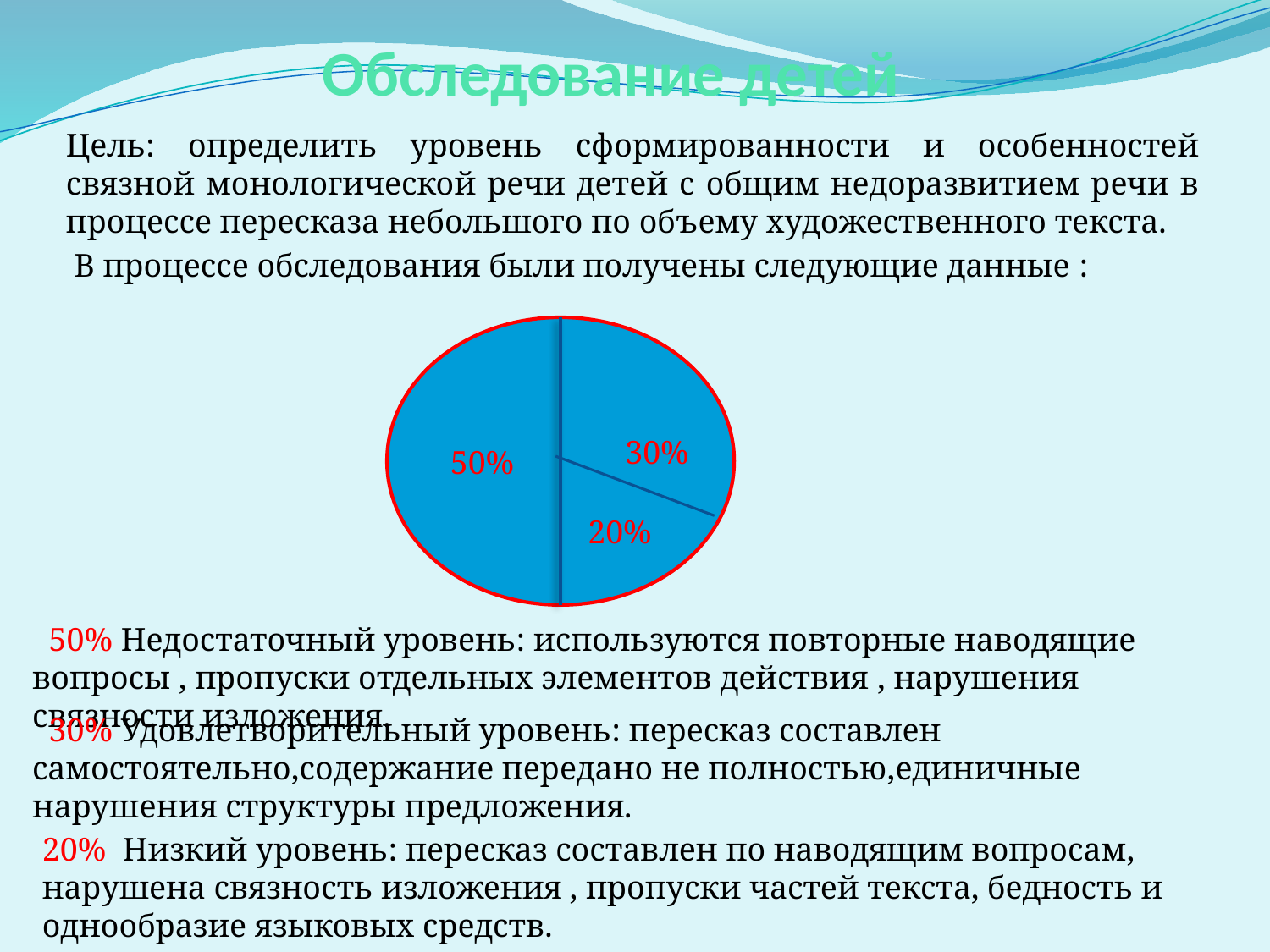
What share of the pie corresponds to the 'Недостаточный уровень' (insufficient level) according to the slide text? 50% What is the smallest share shown in the pie chart? 20% What colour are the slices of the pie chart? blue What is the difference in percentage points between the 30% slice and the 20% slice? 10 How many slices does the pie chart have? 3 Which slice is larger: the one labelled 30% or the one labelled 20%? 30% What share of the pie corresponds to the 'Удовлетворительный уровень' (satisfactory level) according to the slide text? 30% What is the total of all the percentages shown on the pie chart? 100% What is the largest share shown in the pie chart? 50% What share of the pie corresponds to the 'Низкий уровень' (low level) according to the slide text? 20% What is the difference in percentage points between the largest and smallest slices of the pie chart? 30 What kind of chart is shown on the slide? pie chart